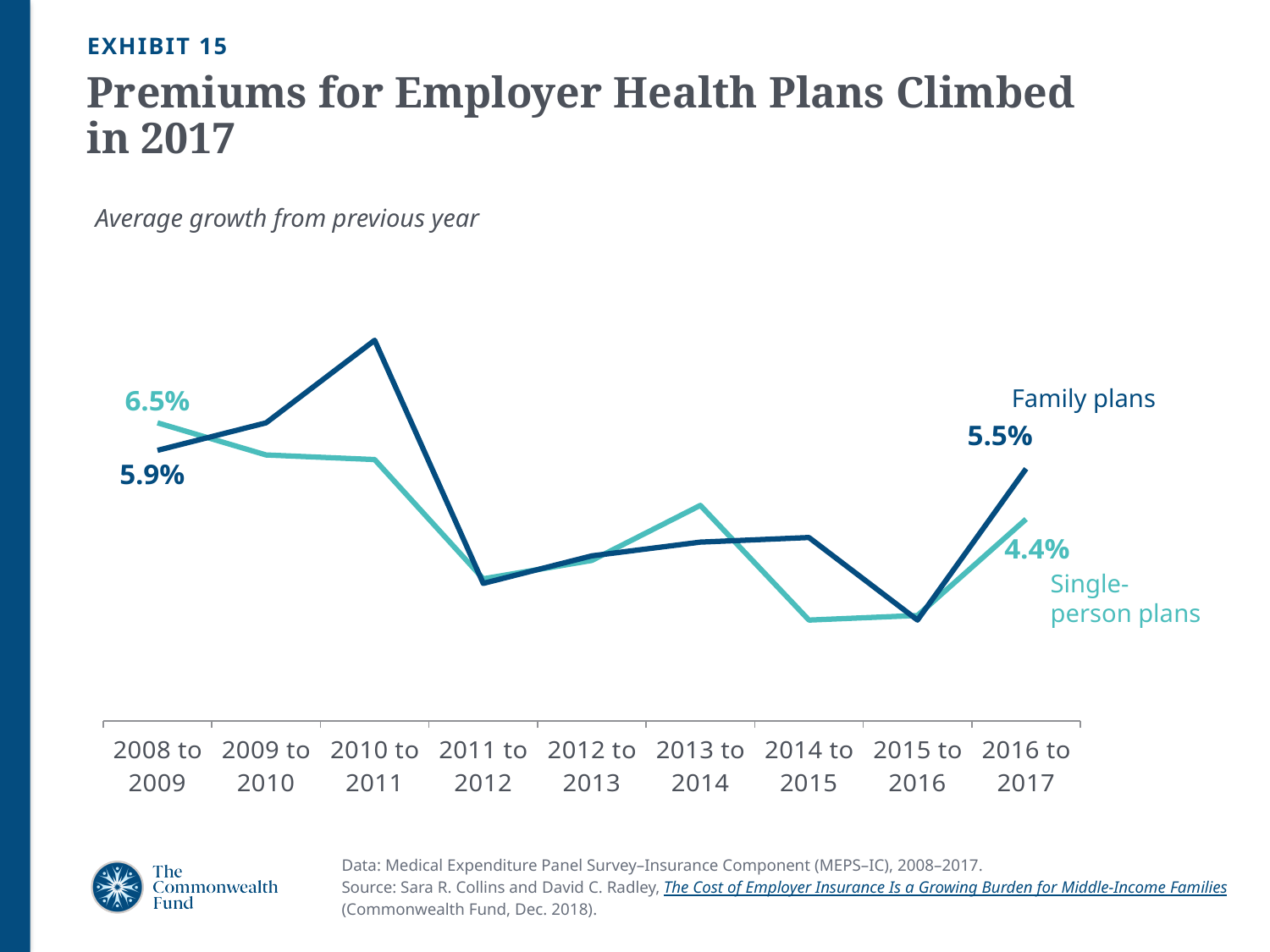
What is the difference between the single-person plan and family plan growth rates in 2008 to 2009? 0.6% What was the average growth for family plans from 2016 to 2017? 5.5% What was the average growth for single-person plans from 2008 to 2009? 6.5% What was the average growth for single-person plans from 2016 to 2017? 4.4% In which period did family plans have their highest growth rate? 2010 to 2011 How much higher was the growth for family plans than for single-person plans in 2016 to 2017? 1.1% In 2016 to 2017, which series had the higher growth rate, family plans or single-person plans? Family plans What type of chart is shown on the slide? Line chart How many year-to-year periods are shown on the x axis? 9 How many series are plotted on the chart? 2 In which period did family plans have their lowest growth rate? 2015 to 2016 What was the average growth for family plans from 2008 to 2009? 5.9%